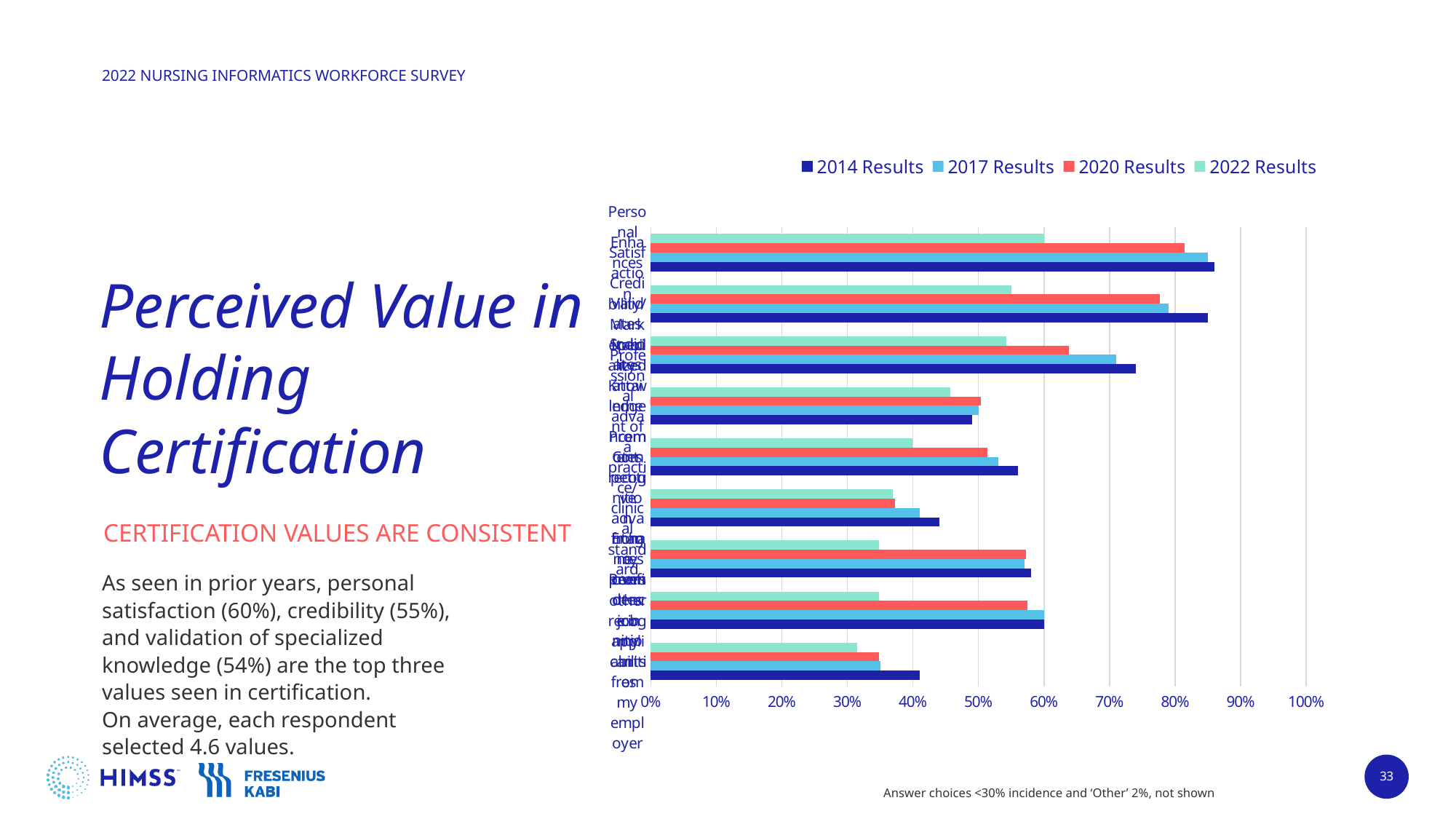
In the topmost group of bars, which series has the longest bar? 2014 Results Do the 2022 Results bars get shorter or longer moving from the top group to the bottom group? shorter In the topmost group of bars, which is larger: the 2014 Results value or the 2022 Results value? 2014 Results How many series does the legend list? 4 In the third group of bars from the top, is the 2014 Results value greater or less than 70%? greater In the second group of bars from the top, is the 2014 Results value greater or less than 80%? greater In the bottom group of bars, is the 2022 Results value greater or less than 40%? less How many groups of bars (categories) are plotted in the chart? 9 Which series are listed in the chart legend? 2014 Results, 2017 Results, 2020 Results, 2022 Results What type of chart is shown on the slide? Bar chart What colour represents the 2020 Results series? Red